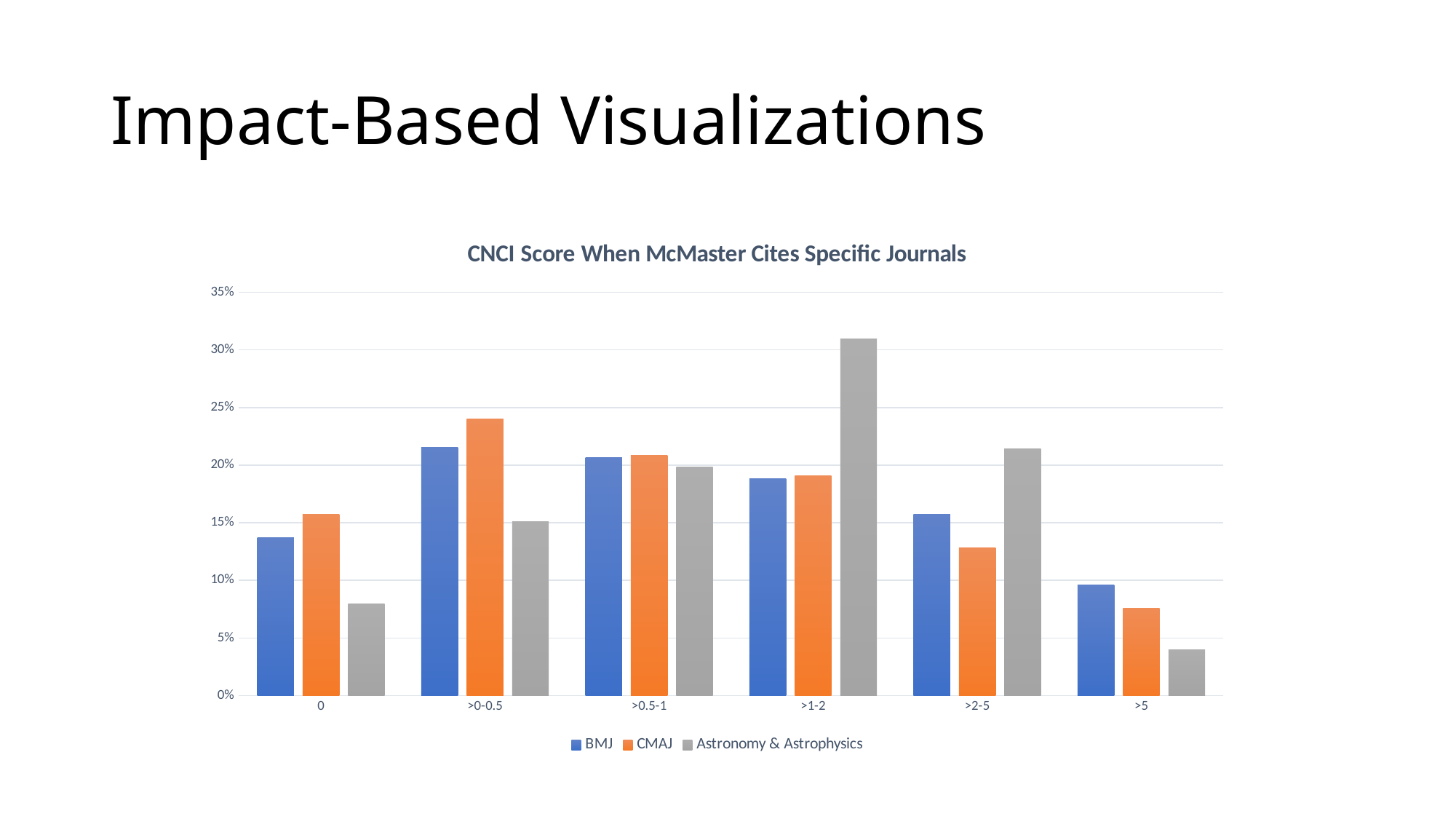
In which category is the Astronomy & Astrophysics bar lowest? >5 In the >2-5 category, which is larger, BMJ or CMAJ? BMJ What kind of chart is shown on the slide? bar chart How many categories are shown on the x axis? 6 In the 0 category, which is larger, CMAJ or Astronomy & Astrophysics? CMAJ Do the BMJ values rise or fall from the >0-0.5 category to the >5 category? fall In which category is the Astronomy & Astrophysics bar highest? >1-2 Is the value for Astronomy & Astrophysics in the >1-2 category greater or less than 30%? greater How many series does the legend list? 3 What is the title of the chart? CNCI Score When McMaster Cites Specific Journals Is the value for BMJ in the 0 category greater or less than 15%? less In which category is the CMAJ bar highest? >0-0.5